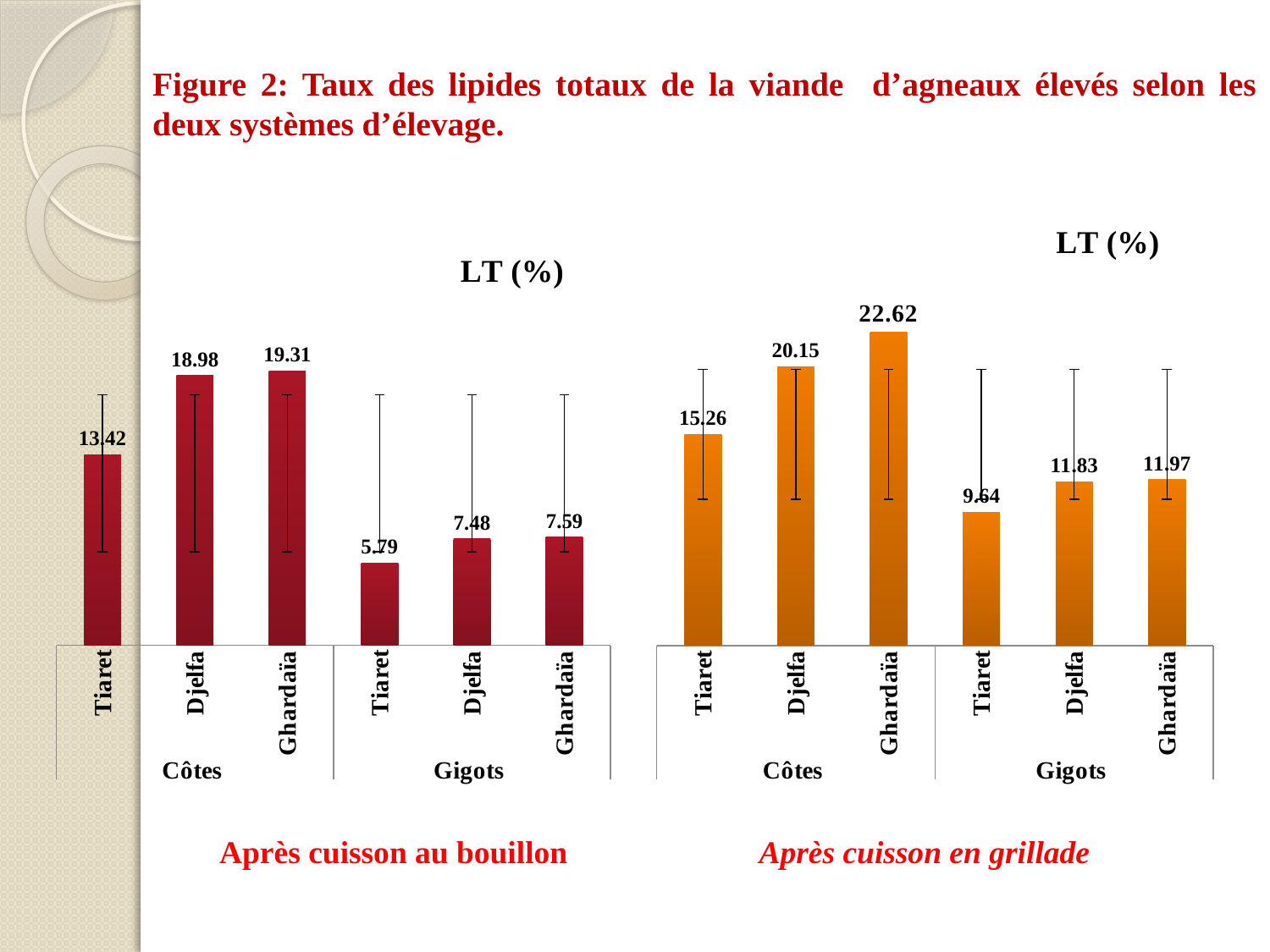
How many bars are plotted in the left chart (Après cuisson au bouillon)? 6 In the right chart (Après cuisson en grillade), what is the difference between the Ghardaïa Côtes value and the Tiaret Côtes value? 7.36 In the right chart (Après cuisson en grillade), which bar has the highest LT (%) value? Ghardaïa (Côtes) In the left chart (Après cuisson au bouillon), what is the difference between the Ghardaïa Côtes value and the Tiaret Côtes value? 5.89 What type of chart is used for Après cuisson en grillade? Bar chart In the right chart (Après cuisson en grillade), which bar has the lowest LT (%) value? Tiaret (Gigots) In the right chart (Après cuisson en grillade), which is larger: the Djelfa Côtes value or the Djelfa Gigots value? Djelfa Côtes In the left chart (Après cuisson au bouillon), what is the LT (%) value for Tiaret in the Côtes group? 13.42 In the left chart (Après cuisson au bouillon), which bar has the lowest LT (%) value? Tiaret (Gigots) What is the title shown above each of the two charts? LT (%) In the left chart (Après cuisson au bouillon), what is the LT (%) value for Djelfa in the Gigots group? 7.48 In the right chart (Après cuisson en grillade), what is the LT (%) value for Ghardaïa in the Gigots group? 11.97